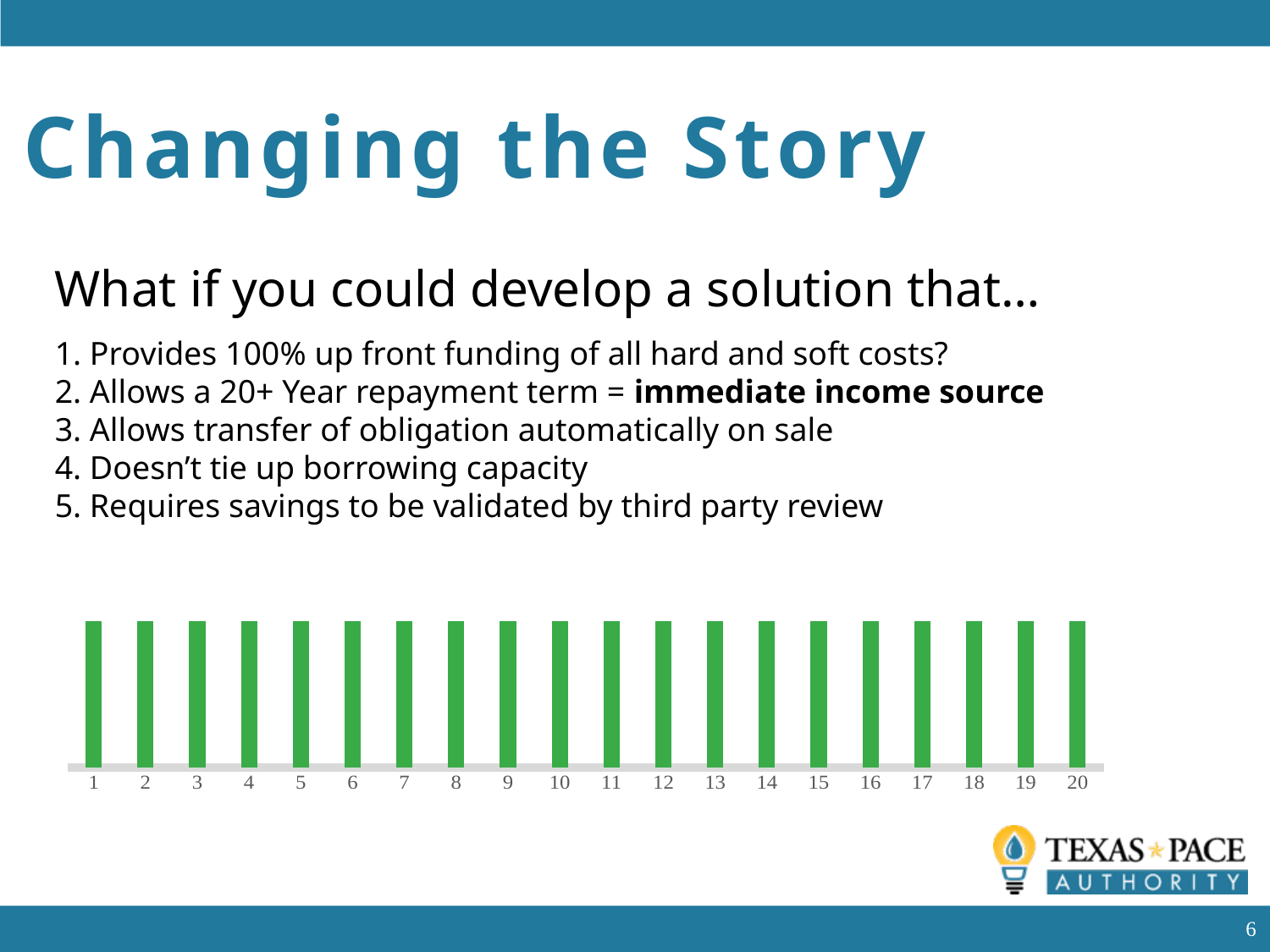
Are the bars in the chart vertical or horizontal? vertical How many bars are plotted in the chart? 20 What is the label of the last category on the x axis of the chart? 20 What kind of chart is shown at the bottom of the slide? bar chart What is the label of the first category on the x axis of the chart? 1 Do the bar heights rise, fall, or stay the same from category 1 to category 20? stay the same